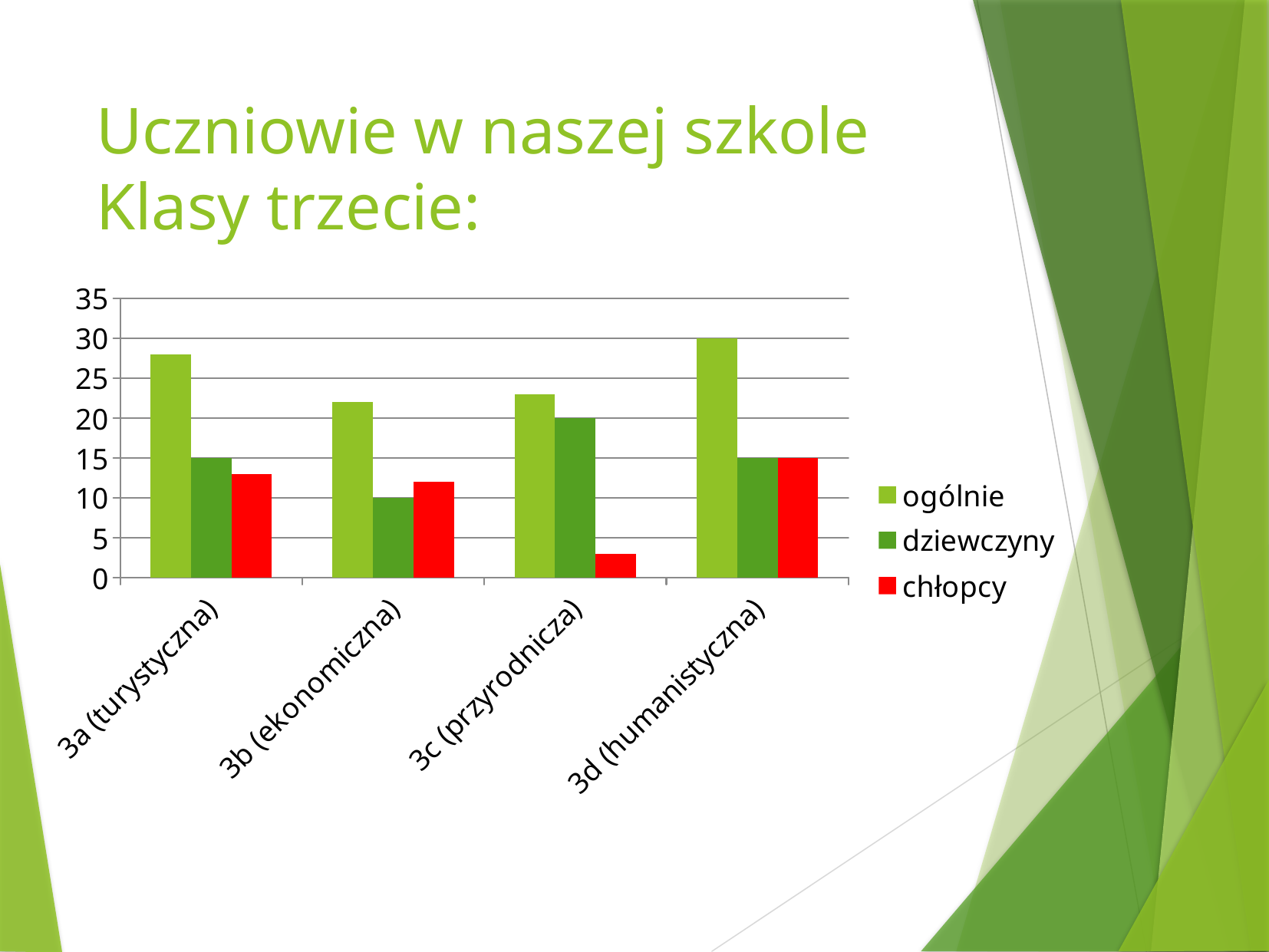
How many classes (categories) are shown on the x axis? 4 What kind of chart is shown on the slide? bar chart Is the value of 'ogólnie' for 3a (turystyczna) greater or less than 25? greater Which class has the lowest value for 'chłopcy'? 3c (przyrodnicza) Is the value of 'chłopcy' for 3c (przyrodnicza) greater or less than 5? less What is the value of 'ogólnie' for 3d (humanistyczna)? 30 What is the value of 'dziewczyny' for 3c (przyrodnicza)? 20 What is the value of 'dziewczyny' for 3b (ekonomiczna)? 10 Which class has the highest value for 'dziewczyny'? 3c (przyrodnicza) How many series does the legend list? 3 What is the value of 'chłopcy' for 3d (humanistyczna)? 15 Which is larger: 'ogólnie' for 3b (ekonomiczna) or 'ogólnie' for 3d (humanistyczna)? 3d (humanistyczna)